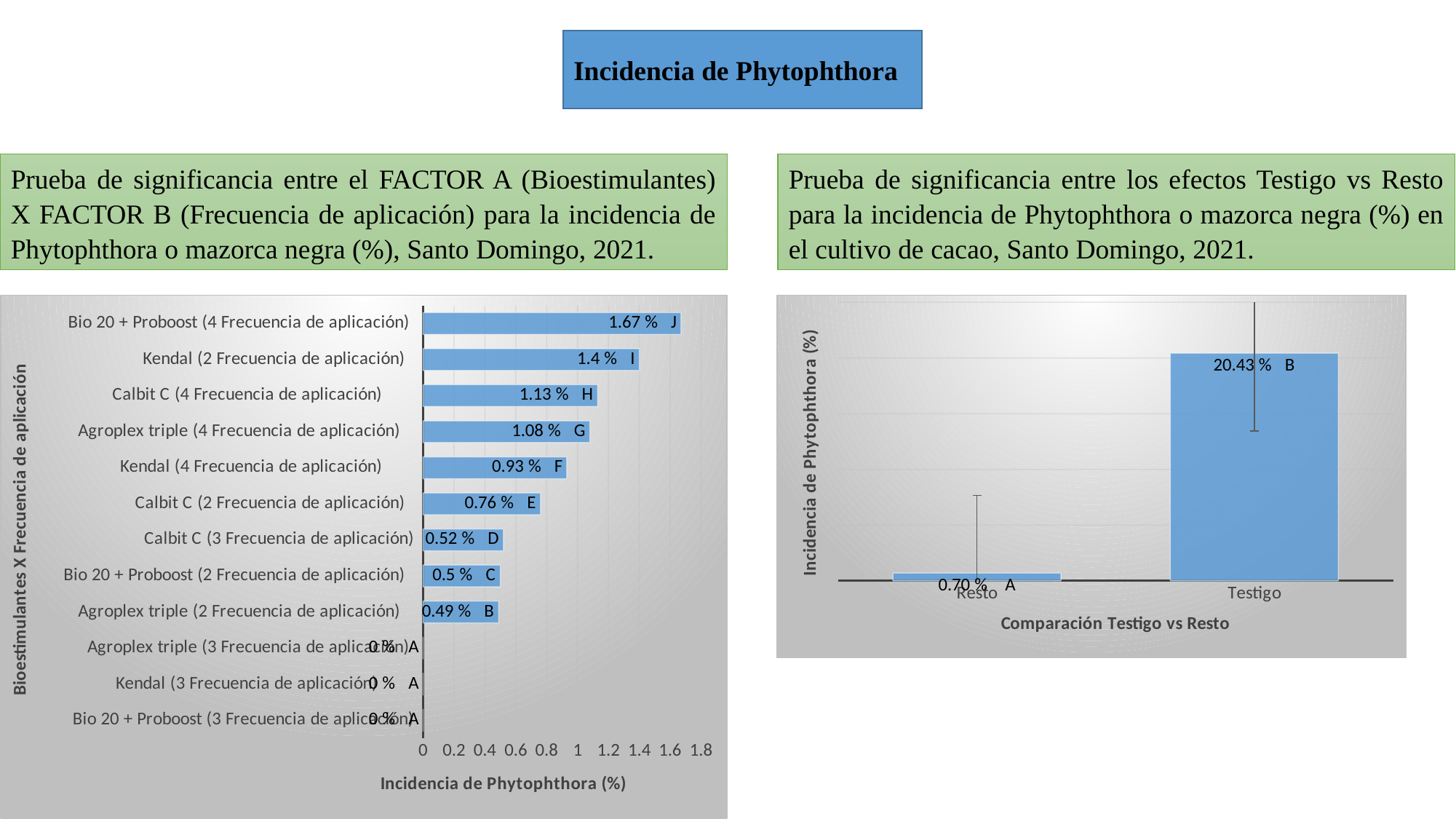
In the left chart, what is the label on the horizontal axis? Incidencia de Phytophthora (%) How many categories are plotted in the right chart? 2 In the right chart, what is the incidence value for Resto? 0.70 % In the left chart, which is larger: the value for Calbit C (2 Frecuencia de aplicación) or Calbit C (3 Frecuencia de aplicación)? Calbit C (2 Frecuencia de aplicación) In the right chart, what is the difference between the values for Testigo and Resto? 19.73 % In the left chart, what is the incidence value for Bio 20 + Proboost (4 Frecuencia de aplicación)? 1.67 % In the left chart, what is the difference between the values for Kendal (2 Frecuencia de aplicación) and Calbit C (4 Frecuencia de aplicación)? 0.27 % In the left chart, which category has the highest incidence of Phytophthora? Bio 20 + Proboost (4 Frecuencia de aplicación) What kind of chart is the left chart? Bar chart In the right chart, what is the incidence value for Testigo? 20.43 % In the left chart, what is the incidence value for Kendal (4 Frecuencia de aplicación)? 0.93 % How many categories are plotted in the left chart? 12